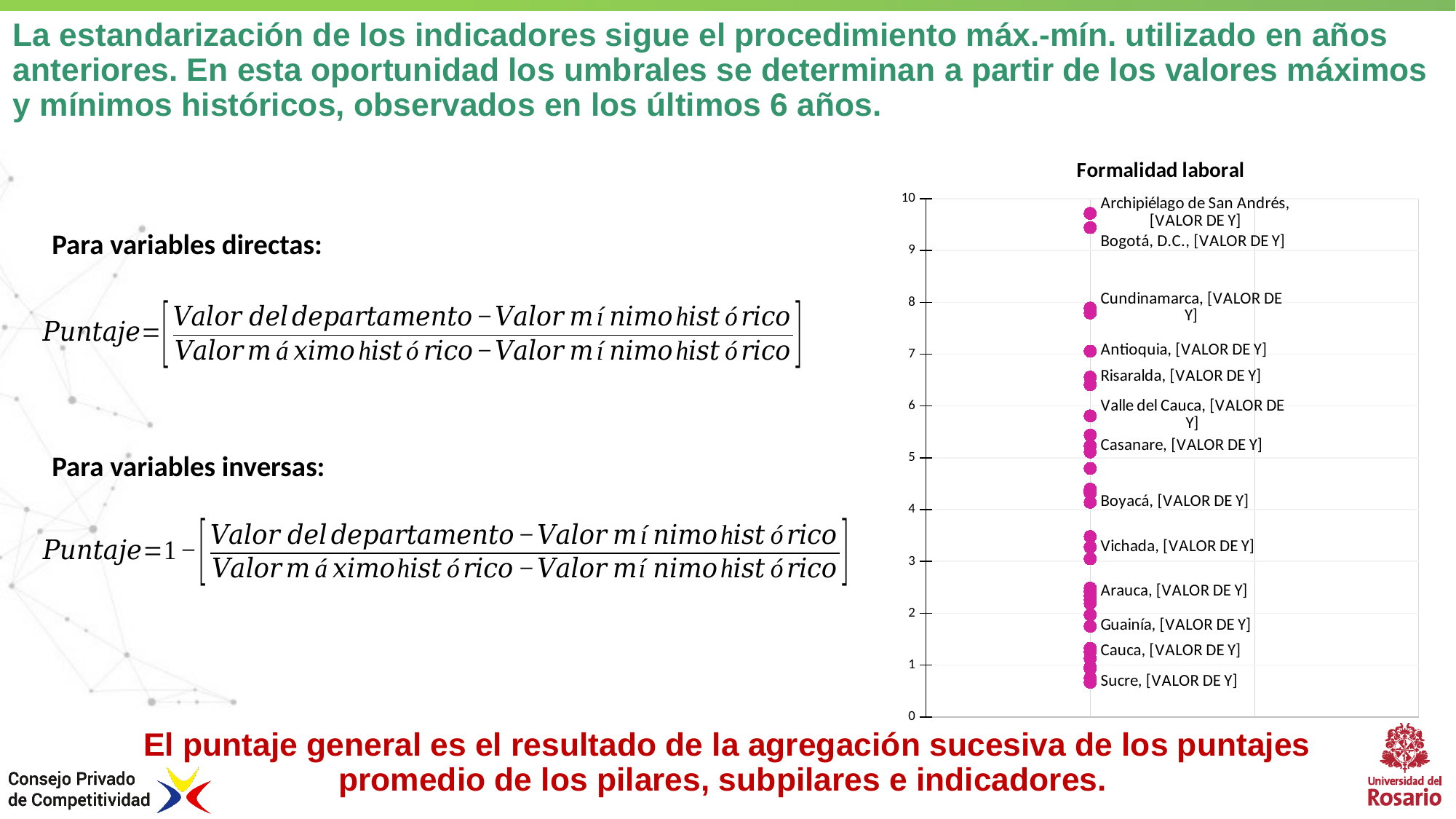
What is the maximum value shown on the y axis of the 'Formalidad laboral' chart? 10 In the 'Formalidad laboral' chart, which has the larger value, Arauca or Valle del Cauca? Valle del Cauca In the 'Formalidad laboral' chart, which has the larger value, Antioquia or Boyacá? Antioquia In the 'Formalidad laboral' chart, is the value for Cauca greater or less than 2? less In the 'Formalidad laboral' chart, is the value for Sucre greater or less than 1? less In the 'Formalidad laboral' chart, is the value for Vichada greater or less than 4? less In the 'Formalidad laboral' chart, which labelled department has the lowest value? Sucre What is the title of the chart on the slide? Formalidad laboral In the 'Formalidad laboral' chart, which labelled department has the highest value? Archipiélago de San Andrés What kind of chart is the 'Formalidad laboral' chart? Scatter (dot) chart